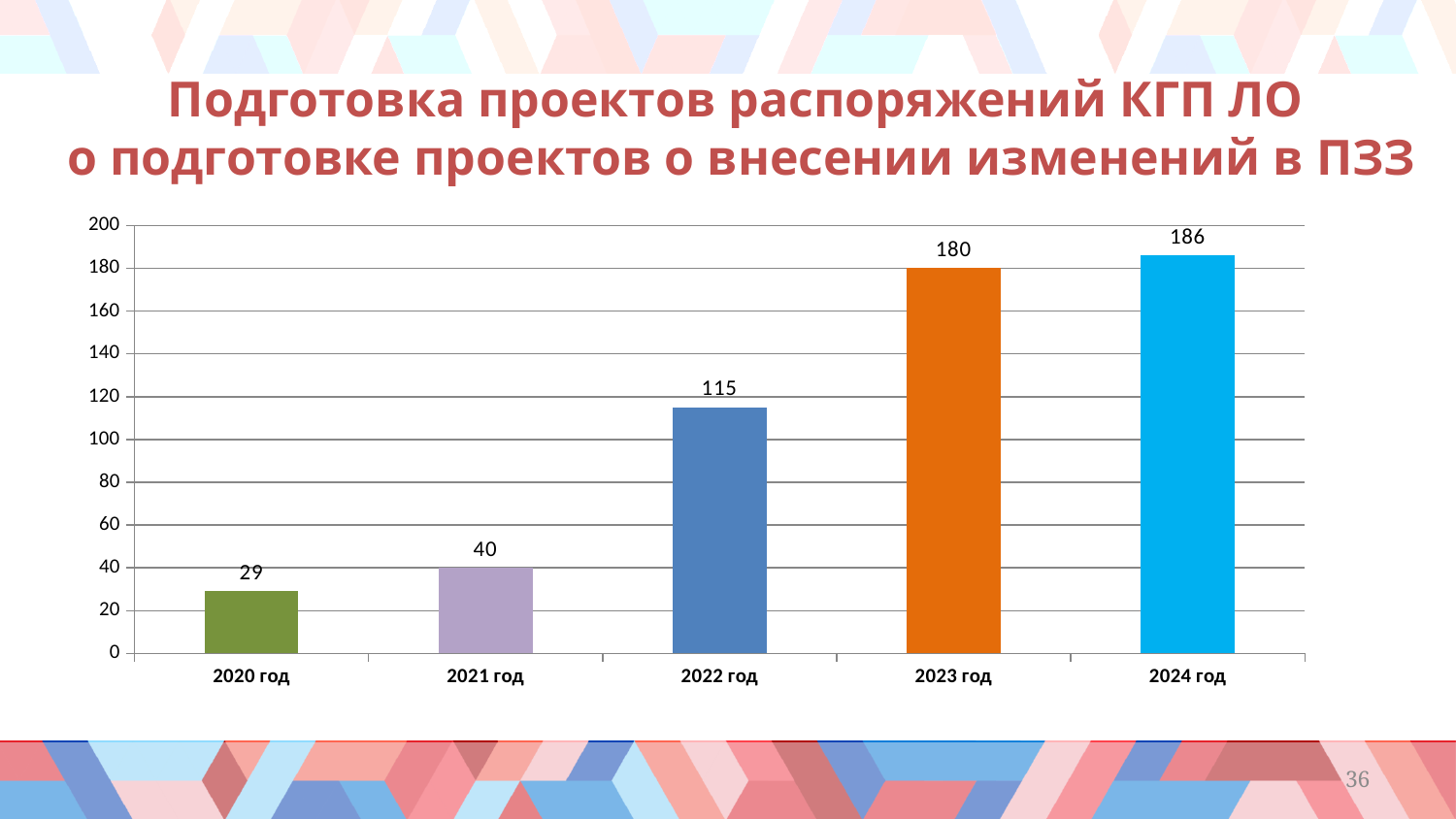
What is the difference between the values for 2021 год and 2020 год? 11 Which is larger, the value for 2021 год or the value for 2022 год? 2022 год What is the value for 2022 год? 115 What kind of chart is shown on the slide? bar chart Which year has the highest value? 2024 год Is the value for 2023 год greater or less than 160? greater Which year has the lowest value? 2020 год What is the value for 2020 год? 29 What is the difference between the values for 2023 год and 2022 год? 65 How many years are shown on the chart? 5 What is the value for 2024 год? 186 Do the values rise or fall from 2020 год to 2024 год? rise